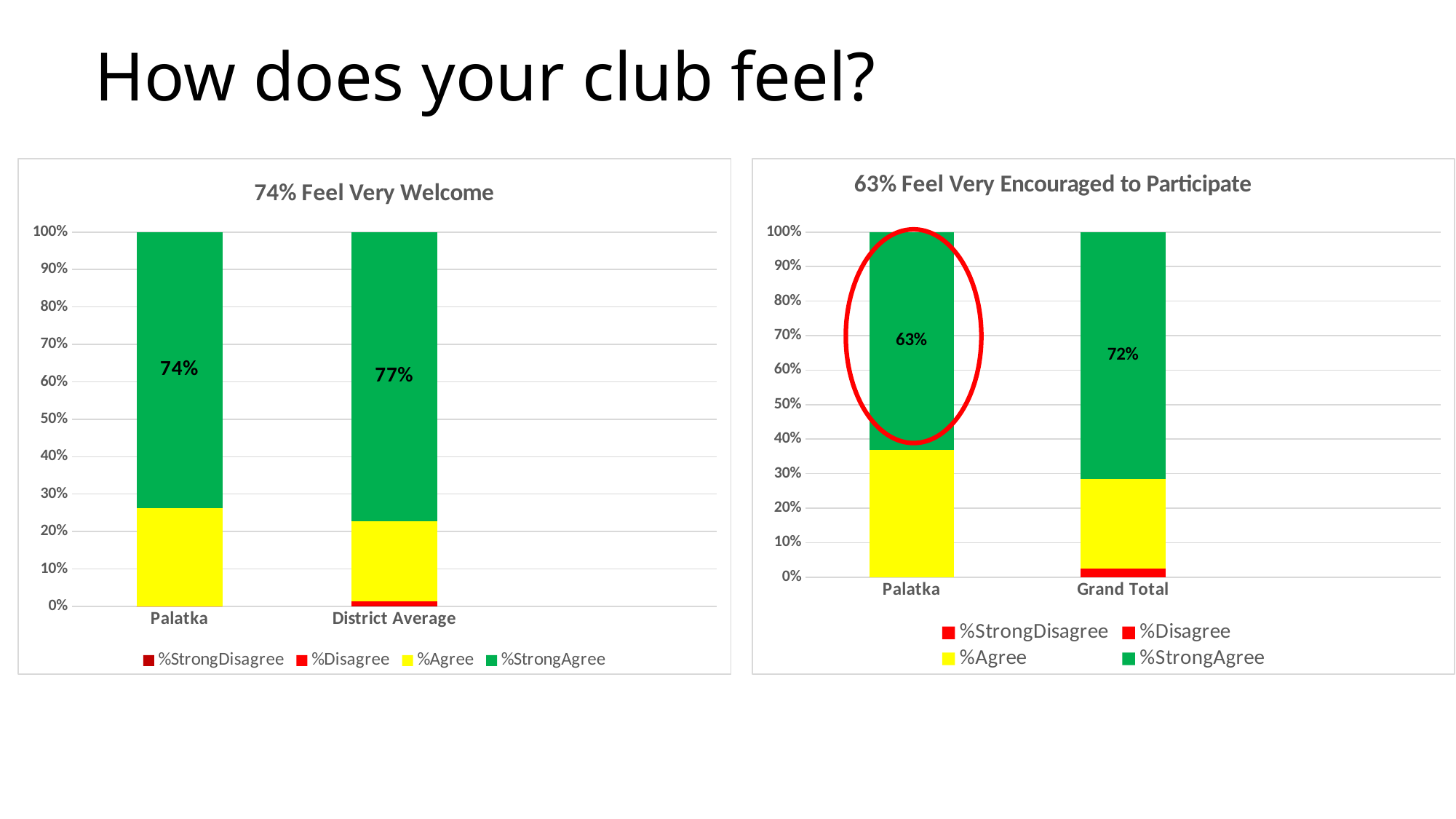
In the chart titled "63% Feel Very Encouraged to Participate", what is the %StrongAgree value for Grand Total? 72% In the chart titled "63% Feel Very Encouraged to Participate", is the top of the %Agree segment for Palatka greater or less than 30%? greater In the chart titled "63% Feel Very Encouraged to Participate", what is the %StrongAgree value for Palatka? 63% What kind of chart is the chart titled "74% Feel Very Welcome"? Stacked bar chart How many categories are shown on the x axis of the chart titled "63% Feel Very Encouraged to Participate"? 2 In the chart titled "74% Feel Very Welcome", which category has the higher %StrongAgree value, Palatka or District Average? District Average In the chart titled "74% Feel Very Welcome", what is the %StrongAgree value for District Average? 77% In the chart titled "63% Feel Very Encouraged to Participate", what is the difference in %StrongAgree between Grand Total and Palatka? 9% In the chart titled "74% Feel Very Welcome", what is the difference in %StrongAgree between District Average and Palatka? 3% In the chart titled "63% Feel Very Encouraged to Participate", which category has the lower %StrongAgree value? Palatka In the chart titled "74% Feel Very Welcome", what is the %StrongAgree value for Palatka? 74% How many series does the legend list in the chart titled "74% Feel Very Welcome"? 4